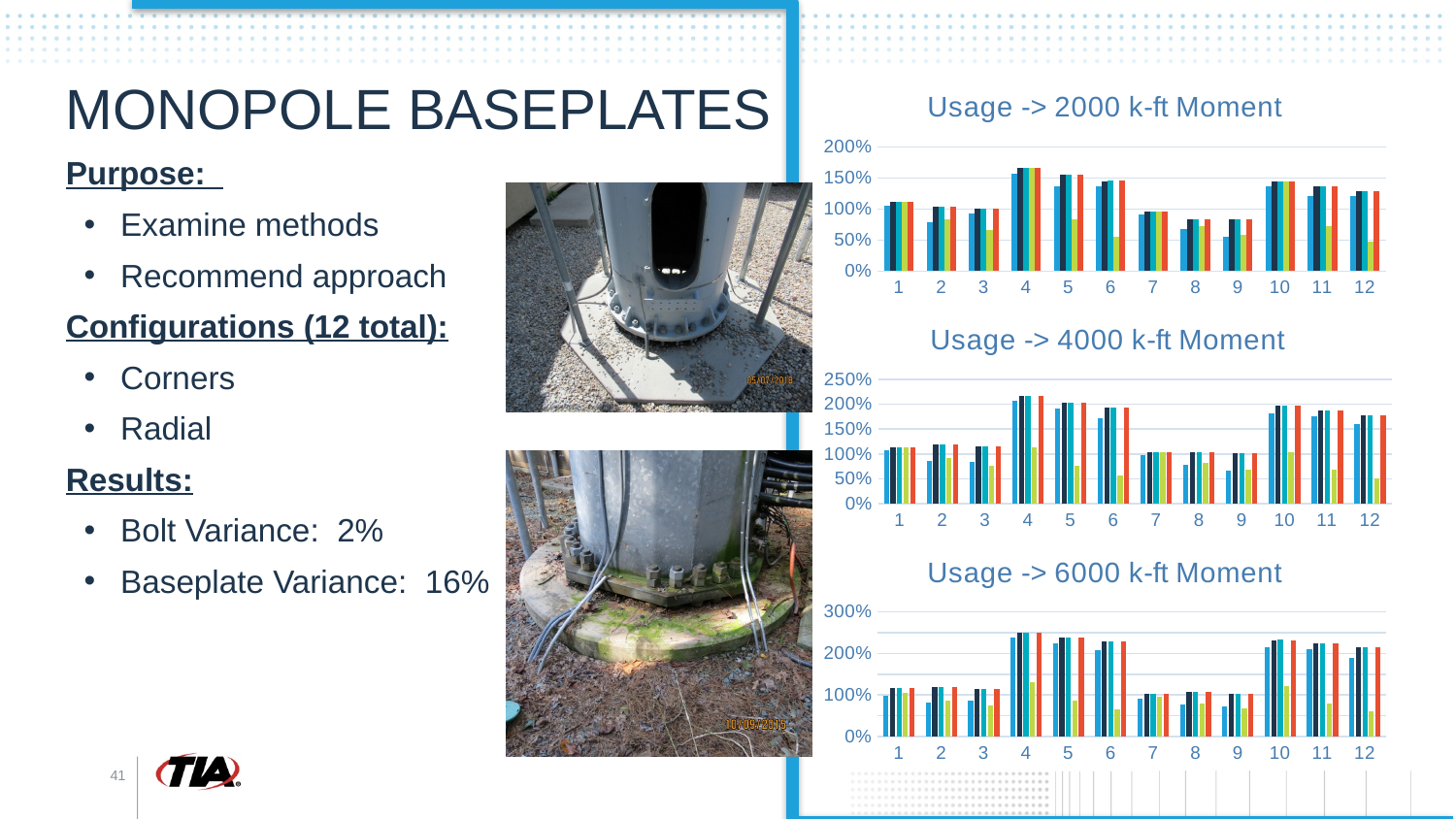
In the 'Usage -> 2000 k-ft Moment' chart, are the bars for category 8 greater or less than 100%? less In the 'Usage -> 6000 k-ft Moment' chart, are the bars for category 7 greater or less than 150%? less In the 'Usage -> 4000 k-ft Moment' chart, is the tallest bar for category 4 greater or less than 200%? greater In the 'Usage -> 4000 k-ft Moment' chart, which category has the tallest bars? 4 What kind of chart is the 'Usage -> 2000 k-ft Moment' chart? bar chart How many categories are on the x axis of the 'Usage -> 4000 k-ft Moment' chart? 12 How many charts are shown on the slide? 3 How many categories are on the x axis of the 'Usage -> 6000 k-ft Moment' chart? 12 In the 'Usage -> 2000 k-ft Moment' chart, which category has the tallest bars? 4 What is the title of the bottom chart on the slide? Usage -> 6000 k-ft Moment